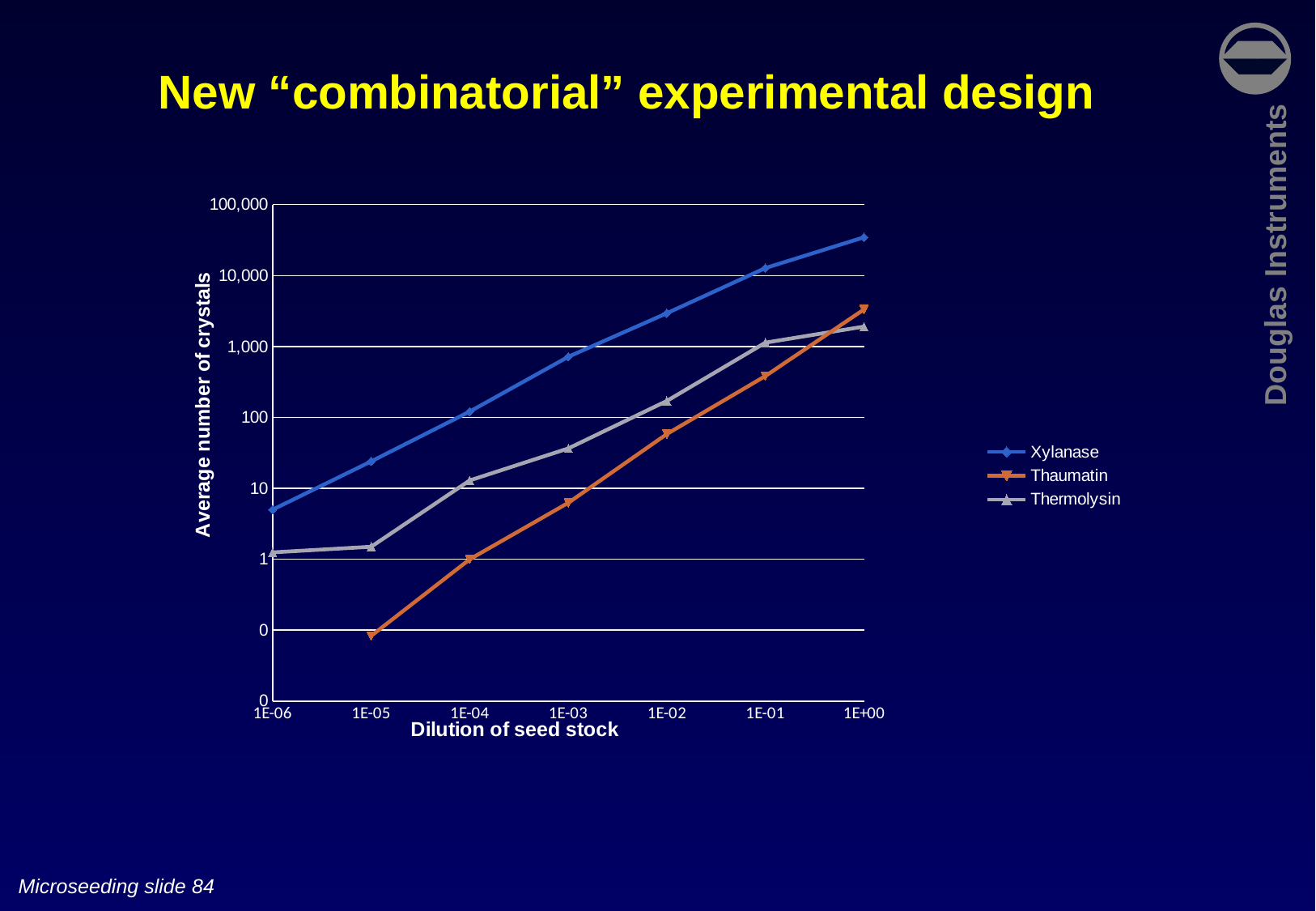
What kind of chart is shown on the slide? line chart Is the value for Thaumatin at a dilution of 1E-03 greater or less than 10? less What is the label of the x axis? Dilution of seed stock What is the label of the y axis? Average number of crystals Does the Xylanase line rise or fall as the dilution of seed stock increases from 1E-06 to 1E+00? rises How many dilution values are marked along the x axis? 7 Which series has the lowest average number of crystals at a dilution of 1E-03? Thaumatin At a dilution of 1E-05, which series has more crystals, Thermolysin or Thaumatin? Thermolysin Is the value for Xylanase at a dilution of 1E+00 greater or less than 10,000? greater At a dilution of 1E+00, which series has more crystals, Thaumatin or Thermolysin? Thaumatin Which series has the highest average number of crystals at a dilution of 1E-02? Xylanase How many series does the legend list? 3